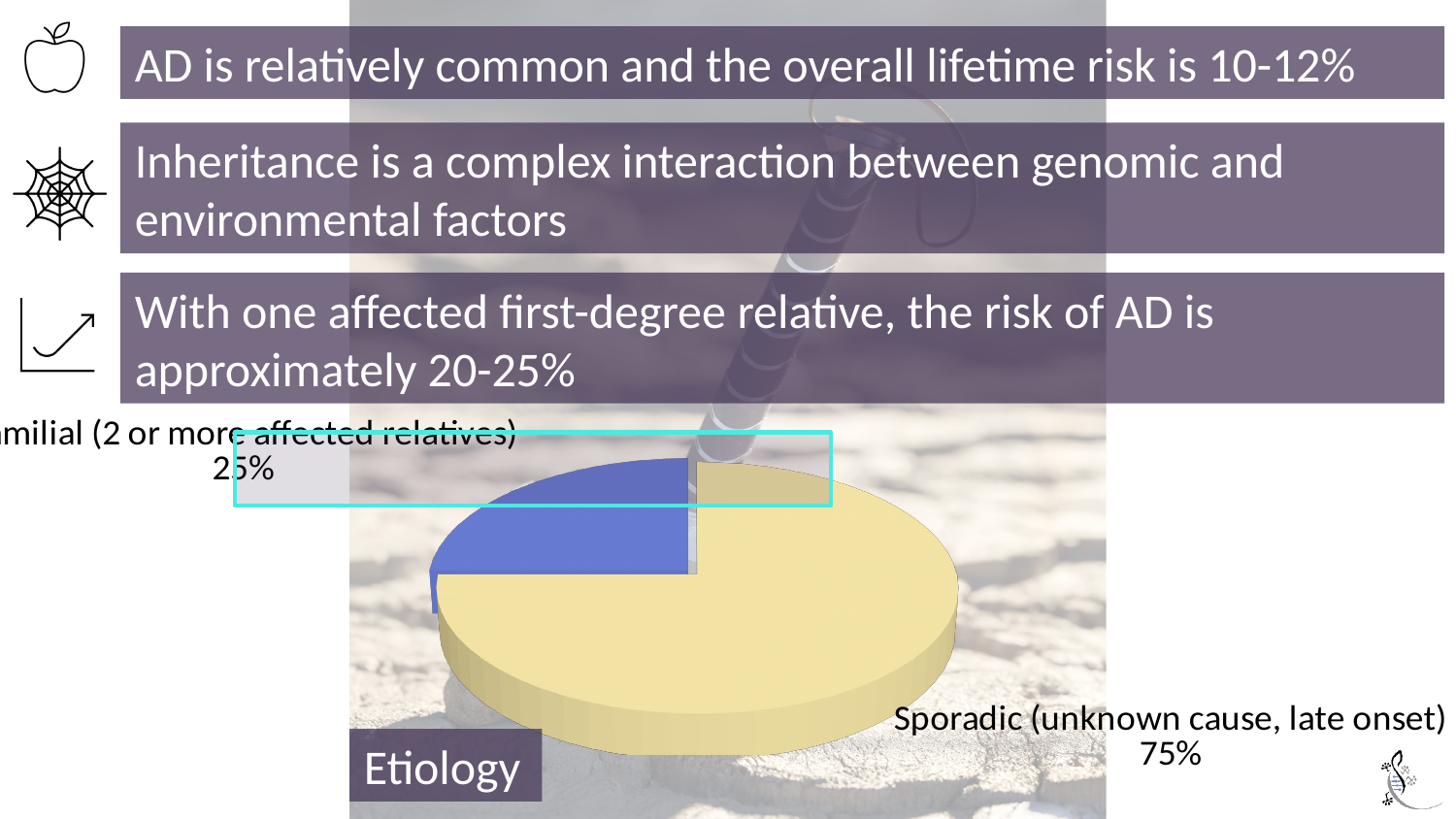
What kind of chart is shown on the slide? pie chart What share of the pie does the Sporadic (unknown cause, late onset) slice represent? 75% What share of the pie does the Familial (2 or more affected relatives) slice represent? 25% What colour is the Sporadic (unknown cause, late onset) slice? yellow Which is larger, the Sporadic slice or the Familial slice? Sporadic What is the difference in percentage points between the Sporadic and Familial slices? 50 How many slices does the pie chart have? 2 What is the title shown next to the pie chart? Etiology Which slice of the pie chart is the smallest? Familial (2 or more affected relatives) Which slice of the pie chart is the largest? Sporadic (unknown cause, late onset)